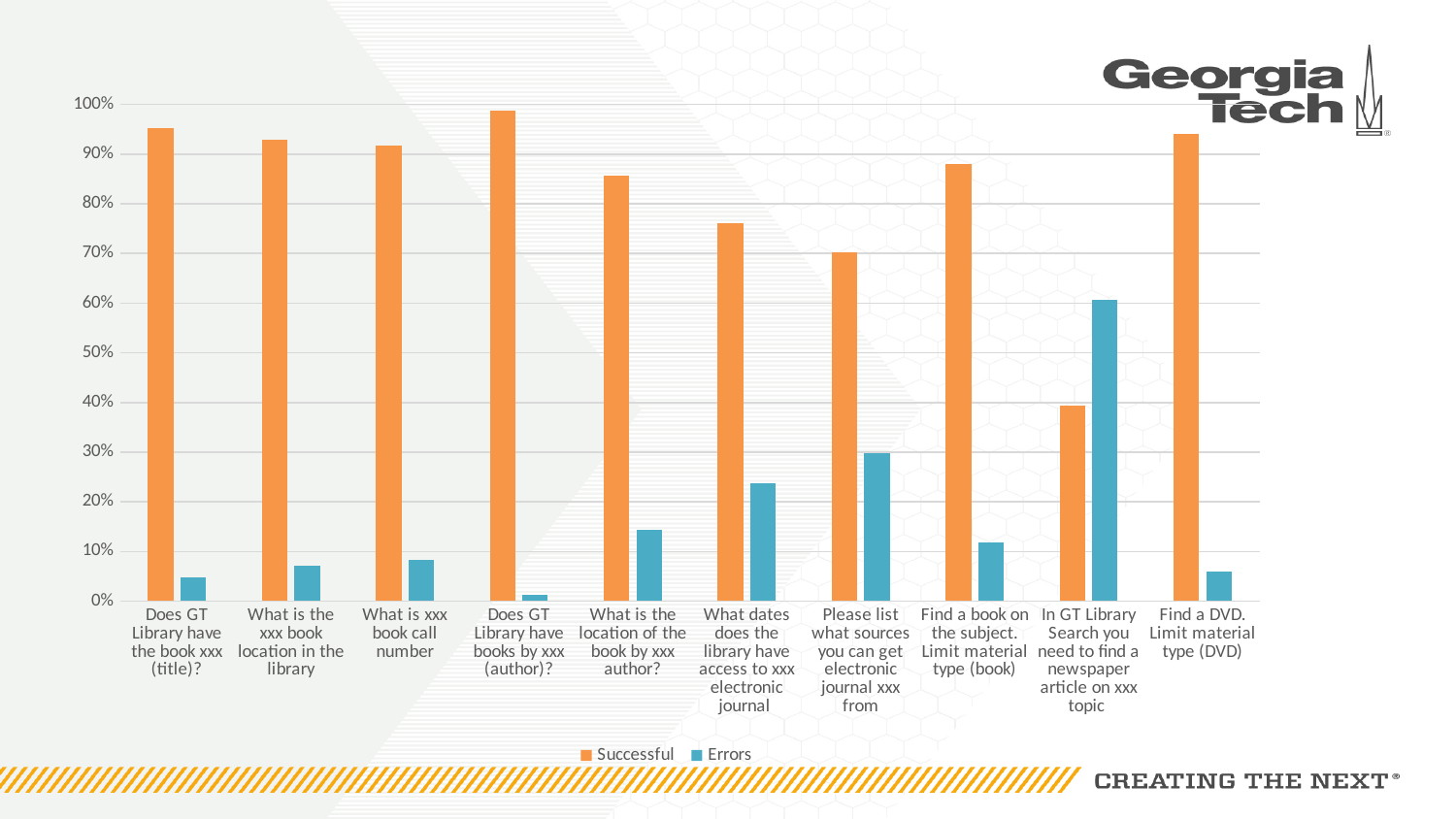
Which is larger: the Successful value for "Find a book on the subject. Limit material type (book)" or the Successful value for "What dates does the library have access to xxx electronic journal"? Find a book on the subject. Limit material type (book) Which task has the lowest Successful value? In GT Library Search you need to find a newspaper article on xxx topic Which task has the lowest Errors value? Does GT Library have books by xxx (author)? How many task categories are shown on the x axis? 10 Which task has the highest Successful value? Does GT Library have books by xxx (author)? Which task has the highest Errors value? In GT Library Search you need to find a newspaper article on xxx topic What kind of chart is shown on the slide? bar chart Is the Successful value for "What is the location of the book by xxx author?" greater or less than 80%? greater How many series does the legend list? 2 Which colour represents the Errors series in the legend? blue Is the Errors value for "Please list what sources you can get electronic journal xxx from" greater or less than 20%? greater Is the Successful value for "Find a DVD. Limit material type (DVD)" greater or less than 90%? greater